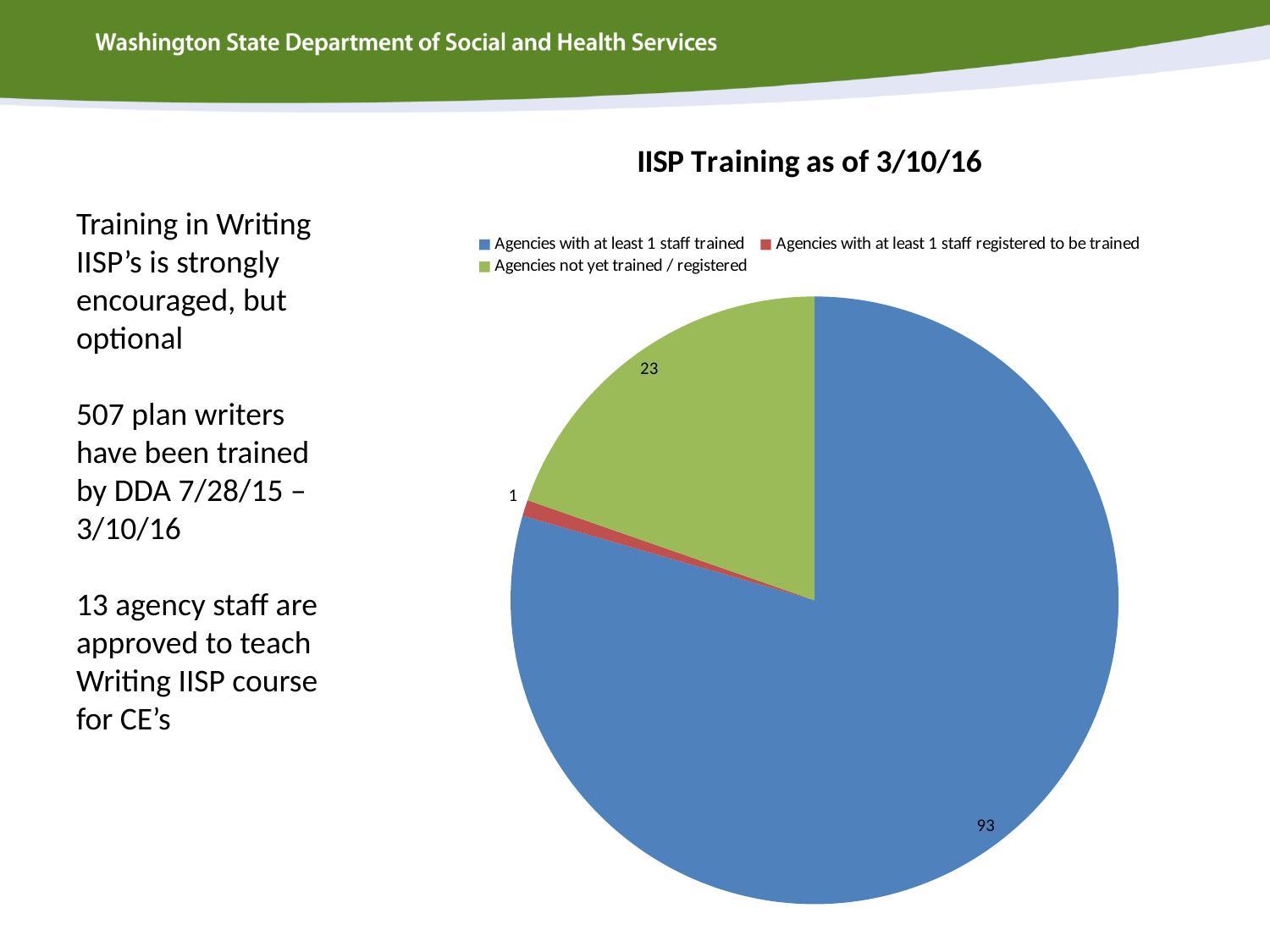
What is the title of the chart? IISP Training as of 3/10/16 What is the value for 'Agencies with at least 1 staff registered to be trained'? 1 Which category has the largest slice of the pie? Agencies with at least 1 staff trained What is the value for 'Agencies with at least 1 staff trained'? 93 What is the difference between the number of agencies with at least 1 staff trained and the number of agencies not yet trained / registered? 70 What type of chart is shown on the slide? Pie chart Which colour represents 'Agencies not yet trained / registered' in the pie chart? Green What is the value for 'Agencies not yet trained / registered'? 23 What is the total of all the slices in the pie chart? 117 How many entries does the chart legend list? 3 Which category has the smallest slice of the pie? Agencies with at least 1 staff registered to be trained How many slices does the pie chart have? 3